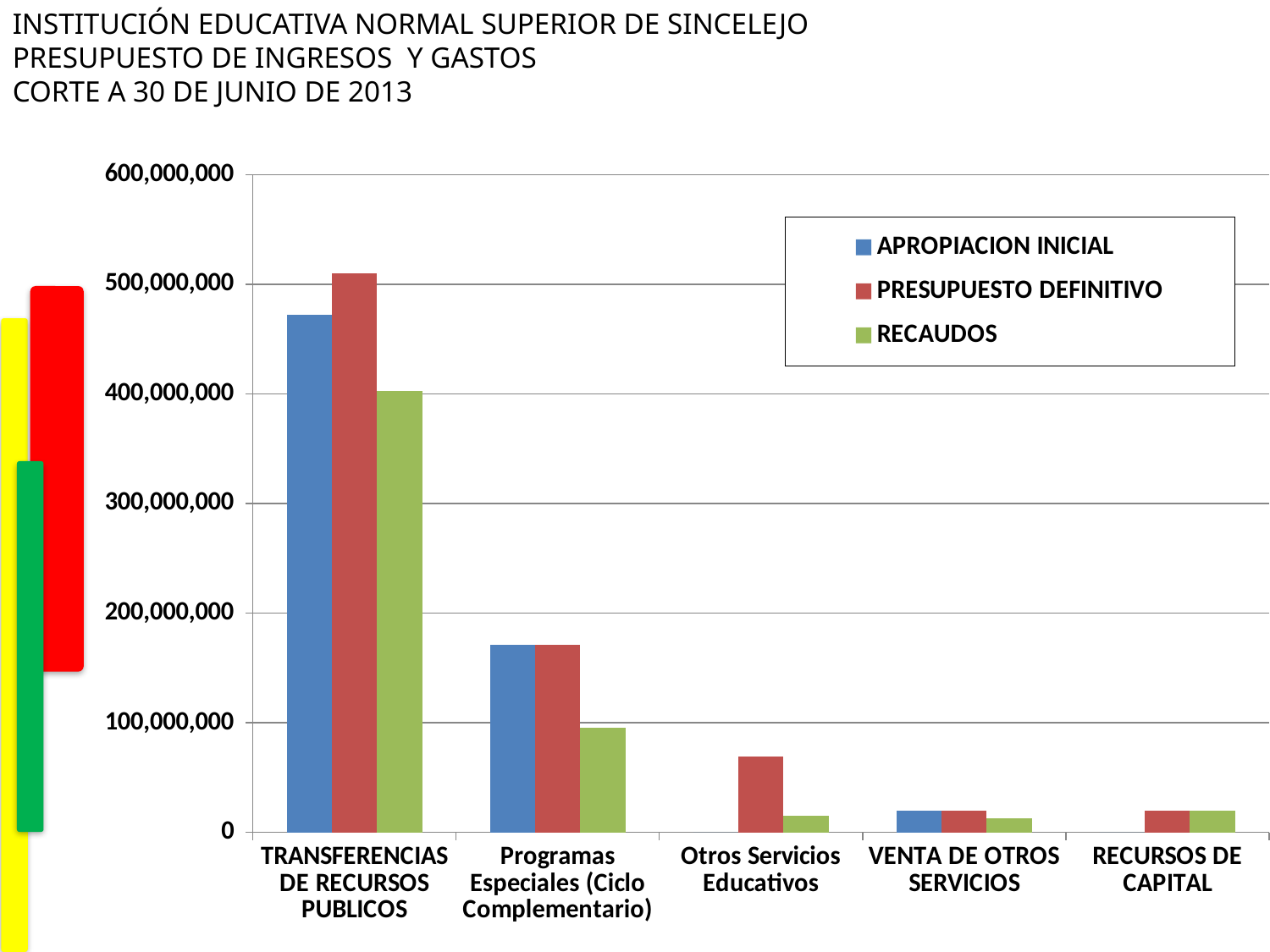
How many categories are shown on the x axis? 5 Is the PRESUPUESTO DEFINITIVO value for Otros Servicios Educativos greater or less than 100,000,000? less How many series does the legend list? 3 Is the APROPIACION INICIAL value for TRANSFERENCIAS DE RECURSOS PUBLICOS greater or less than 500,000,000? less Is the RECAUDOS value for Programas Especiales (Ciclo Complementario) greater or less than 100,000,000? less What kind of chart is shown on the slide? Bar chart Which category has the highest PRESUPUESTO DEFINITIVO value? TRANSFERENCIAS DE RECURSOS PUBLICOS What colour represents the RECAUDOS series in the legend? Green For Programas Especiales (Ciclo Complementario), which is larger: APROPIACION INICIAL or RECAUDOS? APROPIACION INICIAL For TRANSFERENCIAS DE RECURSOS PUBLICOS, which is larger: PRESUPUESTO DEFINITIVO or RECAUDOS? PRESUPUESTO DEFINITIVO